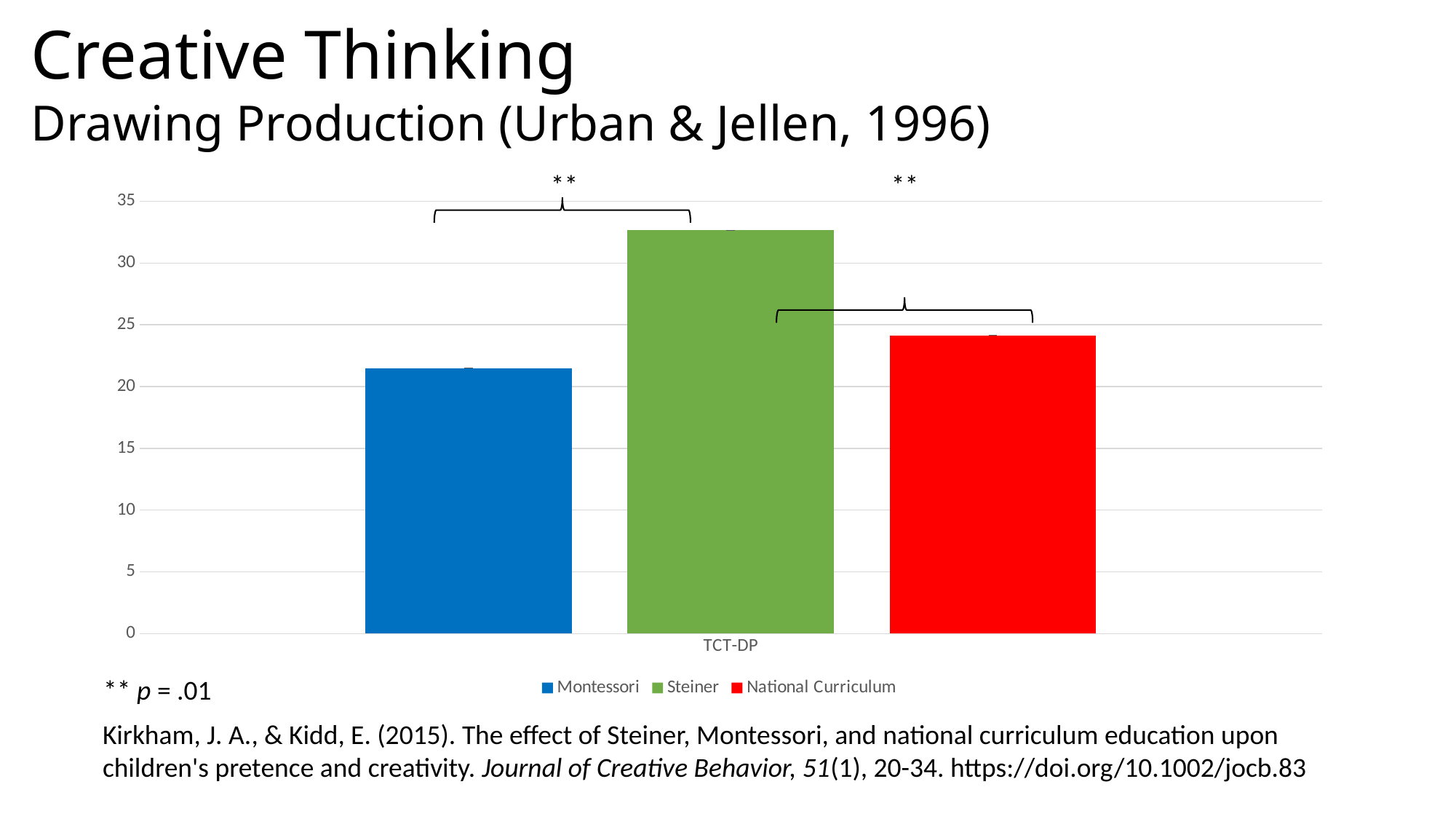
Which series has the highest bar? Steiner Is the value for National Curriculum greater or less than 20? greater What is the label on the x axis of the chart? TCT-DP What kind of chart is shown on the slide? bar chart Which series is shown in green in the legend? Steiner Is the value for Montessori greater or less than 25? less How many categories are shown on the x axis? 1 How many series does the legend list? 3 Is the value for Steiner greater or less than 30? greater Which series has the lowest bar? Montessori Which is larger, the bar for Steiner or the bar for National Curriculum? Steiner Which is larger, the bar for National Curriculum or the bar for Montessori? National Curriculum